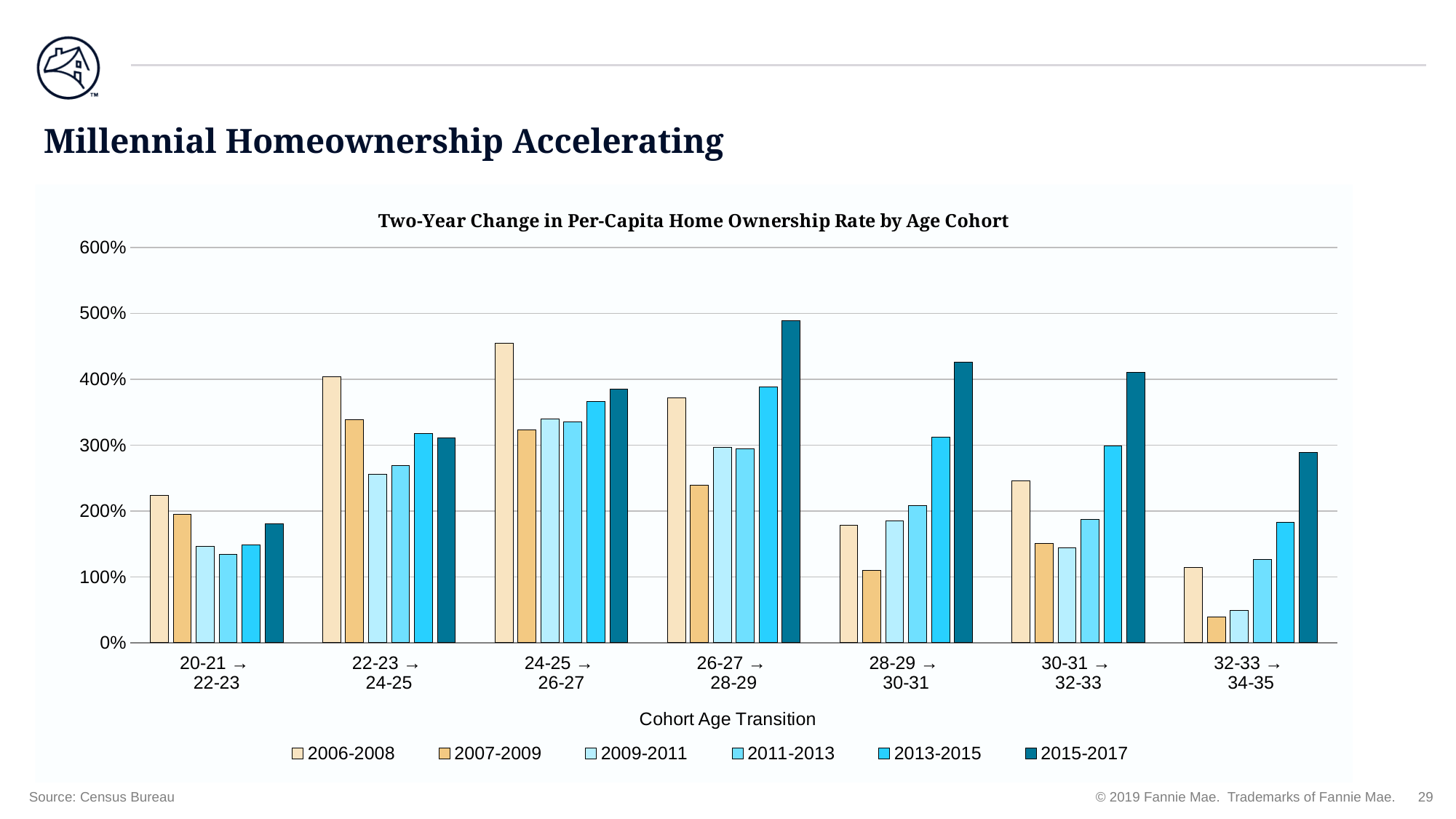
Within the 20-21 → 22-23 transition, which series has the highest value? 2006-2008 For the 2015-2017 series, which cohort age transition has the highest value? 26-27 → 28-29 How many cohort age transitions are shown on the x axis? 7 For the 2007-2009 series, which cohort age transition has the lowest value? 32-33 → 34-35 What is the title of the chart? Two-Year Change in Per-Capita Home Ownership Rate by Age Cohort For the 28-29 → 30-31 transition, which is larger: the 2006-2008 value or the 2015-2017 value? 2015-2017 Is the 2015-2017 value for the 26-27 → 28-29 transition greater or less than 400%? greater How many series does the legend list? 6 Is the 2006-2008 value for the 24-25 → 26-27 transition greater or less than 400%? greater What kind of chart is shown on the slide? Bar chart For the 22-23 → 24-25 transition, which is larger: the 2006-2008 value or the 2015-2017 value? 2006-2008 Is the 2007-2009 value for the 32-33 → 34-35 transition greater or less than 100%? less